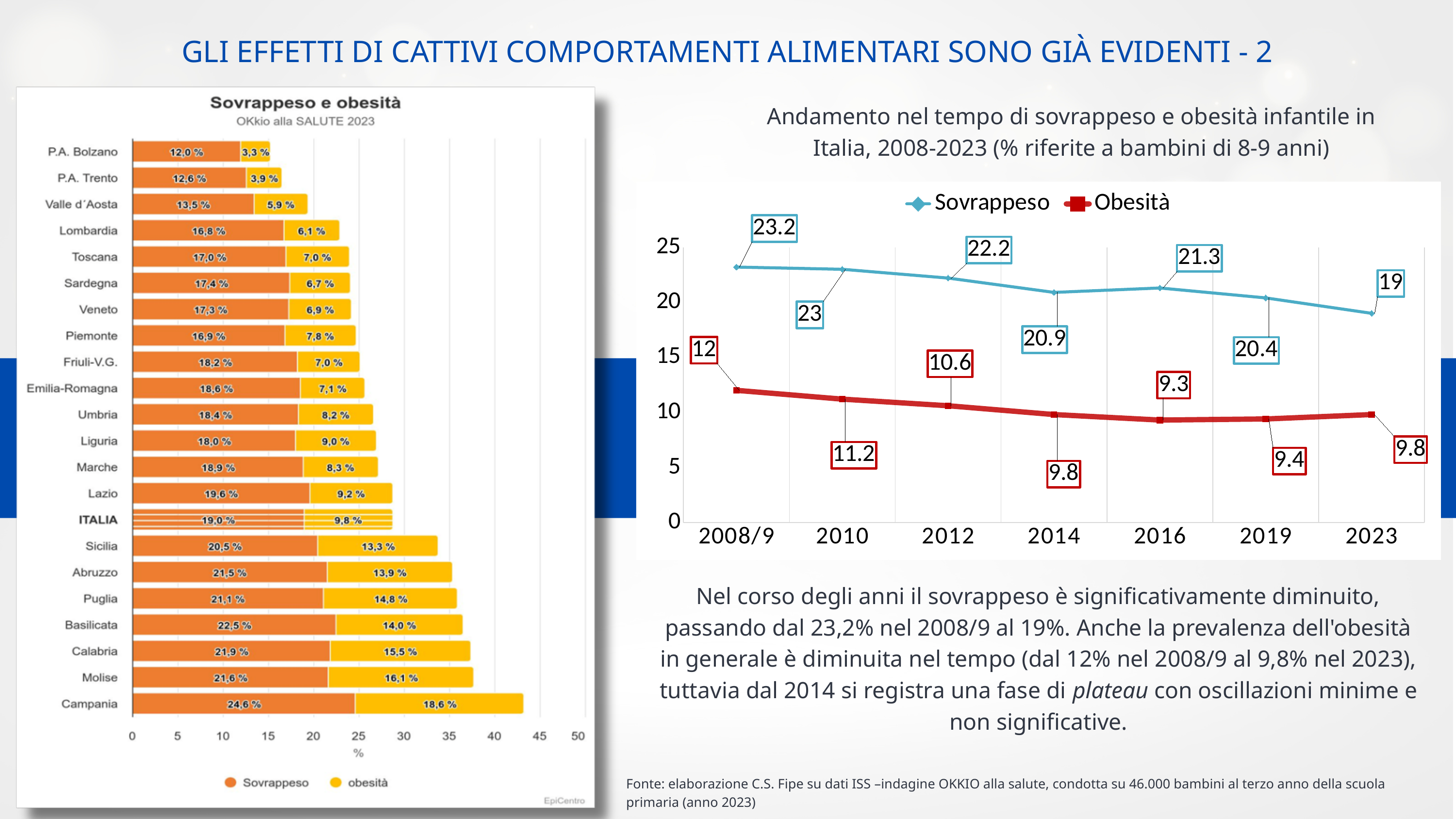
In the 'Sovrappeso e obesità' chart on the left, which region has the lowest obesità value? P.A. Bolzano In the line chart on the right, in which year is the Obesità series highest? 2008/9 In the line chart on the right, how many years are plotted on the x axis? 7 What kind of chart is the 'Sovrappeso e obesità' chart on the left? stacked bar chart In the 'Sovrappeso e obesità' chart on the left, what is the total of the Campania bar (Sovrappeso plus obesità)? 43,2 % In the line chart on the right, in which year is the Sovrappeso series lowest? 2023 In the line chart on the right, by how much did the Sovrappeso value fall from 2008/9 to 2023? 4.2 In the 'Sovrappeso e obesità' chart on the left, what is the Sovrappeso value for Campania? 24,6 % In the line chart on the right, how many series does the legend list? 2 In the line chart on the right, what is the Sovrappeso value for 2008/9? 23.2 In the line chart on the right, what is the Obesità value for 2023? 9.8 In the line chart on the right, does the Sovrappeso series generally rise or fall from 2008/9 to 2023? fall